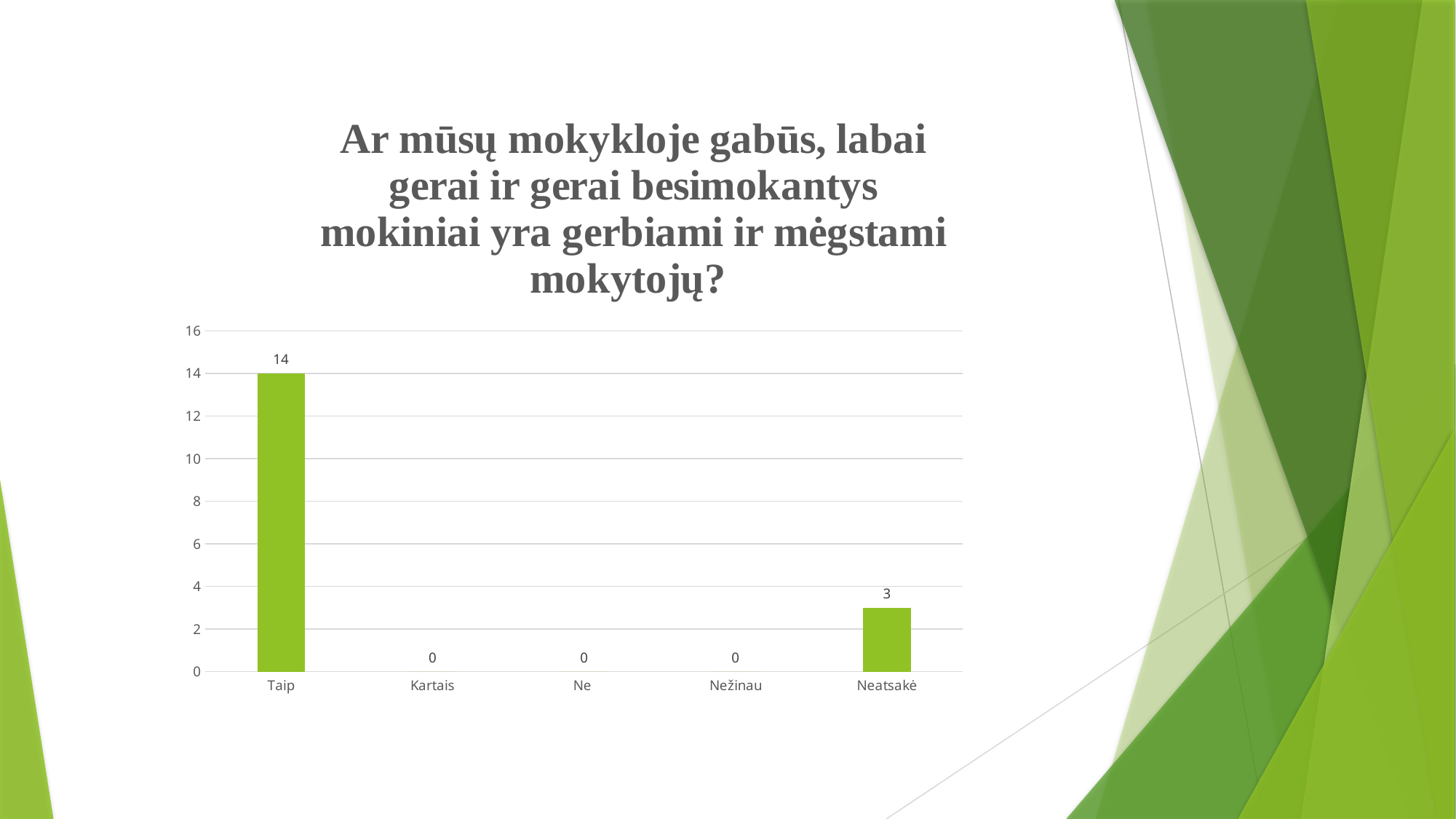
What is the value for Nežinau? 0 What is the difference between the values for Taip and Neatsakė? 11 What is the value for Taip? 14 Which category has the highest value? Taip Is the value for Taip greater or less than 10? greater How many categories are shown on the x axis? 5 What is the value for Kartais? 0 How many categories have a value of 0? 3 What is the total of all the values shown in the chart? 17 What is the value for Neatsakė? 3 What kind of chart is shown on the slide? bar chart Which is larger, the value for Taip or the value for Neatsakė? Taip